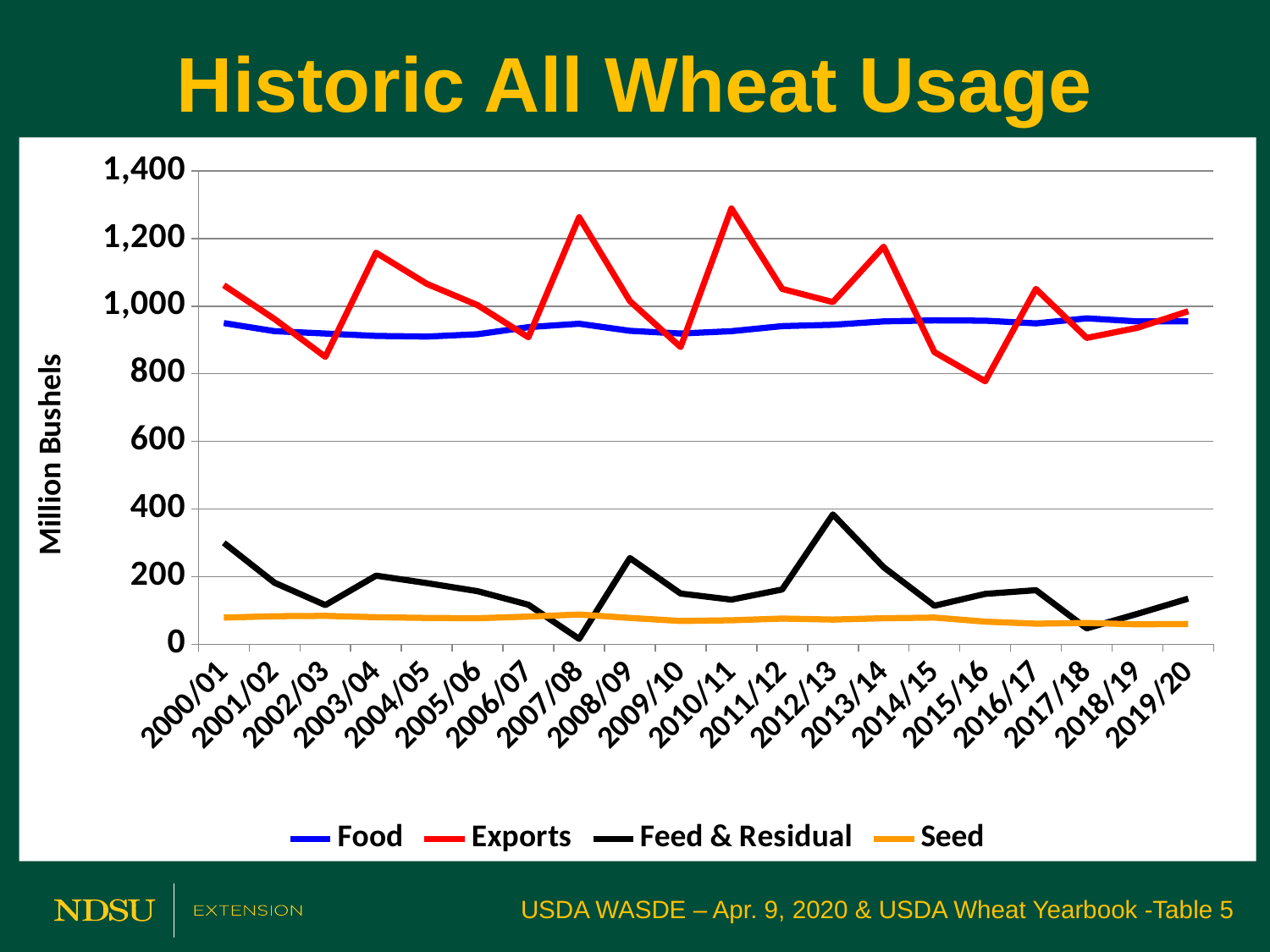
Is the Feed & Residual value for 2007/08 greater or less than 100? less In 2010/11, which is larger, Exports or Food? Exports Is the Exports value for 2010/11 greater or less than 1,200? greater Is the Exports value for 2002/03 greater or less than 1,000? less How many series does the legend list? 4 What kind of chart is shown on the slide? line chart Do Exports rise or fall from 2013/14 to 2015/16? fall Which year has the lowest Feed & Residual value? 2007/08 How many marketing years are shown along the x axis? 20 In 2015/16, which is larger, Food or Exports? Food What is the label on the y axis? Million Bushels